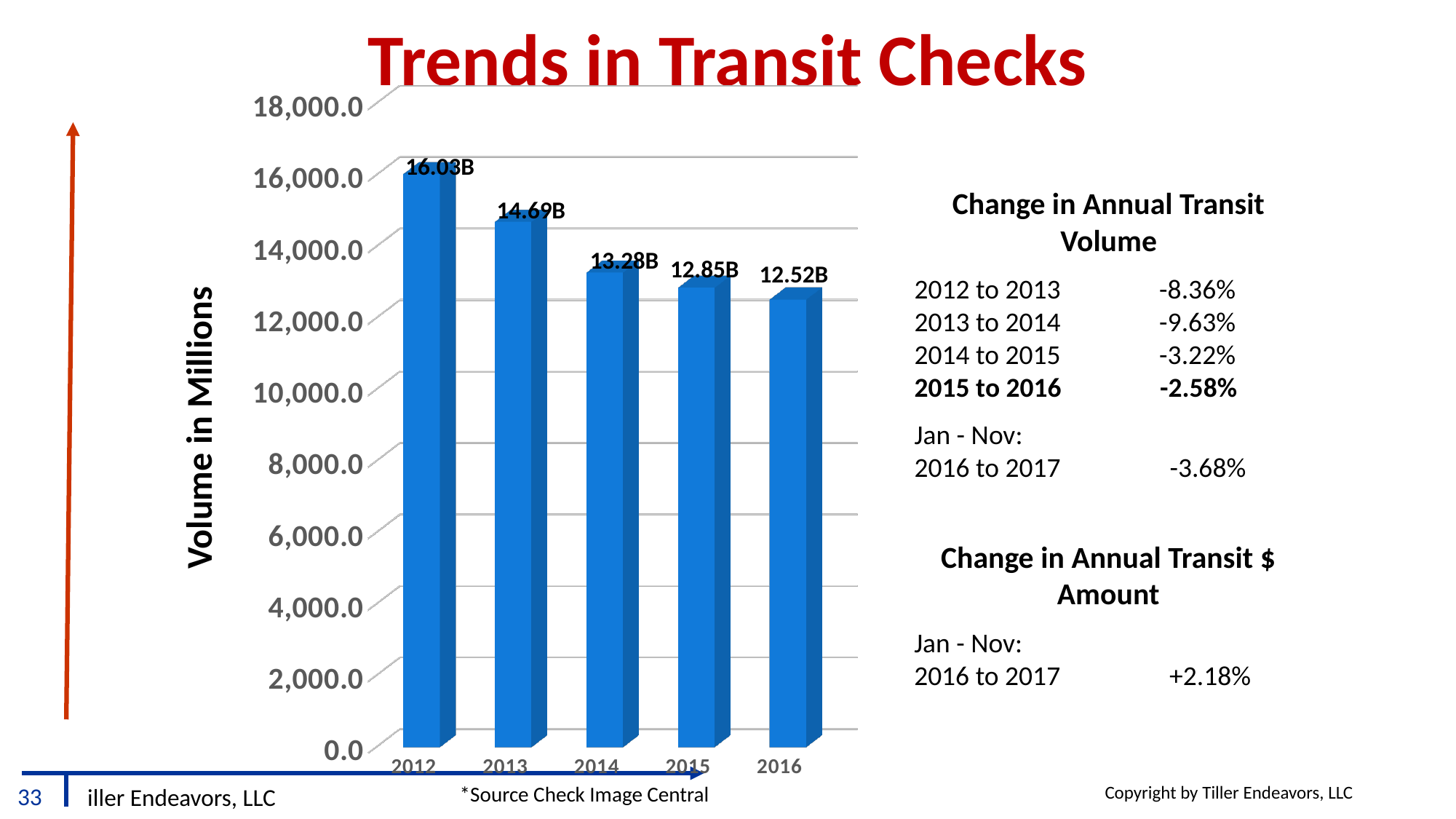
Which is larger, the value for 2013 or the value for 2015? 2013 Is the value for 2014 greater or less than 14,000.0? less What is the value shown for 2016? 12.52B What is the difference between the values for 2015 and 2016? 0.33B Which year has the lowest transit check volume? 2016 What is the value shown for 2014? 13.28B What kind of chart is shown on the slide? bar chart What is the value shown for 2012? 16.03B What is the difference between the values for 2012 and 2013? 1.34B Which year has the highest transit check volume? 2012 How many years are shown on the x axis of the chart? 5 Do the values rise or fall from 2012 to 2016? fall